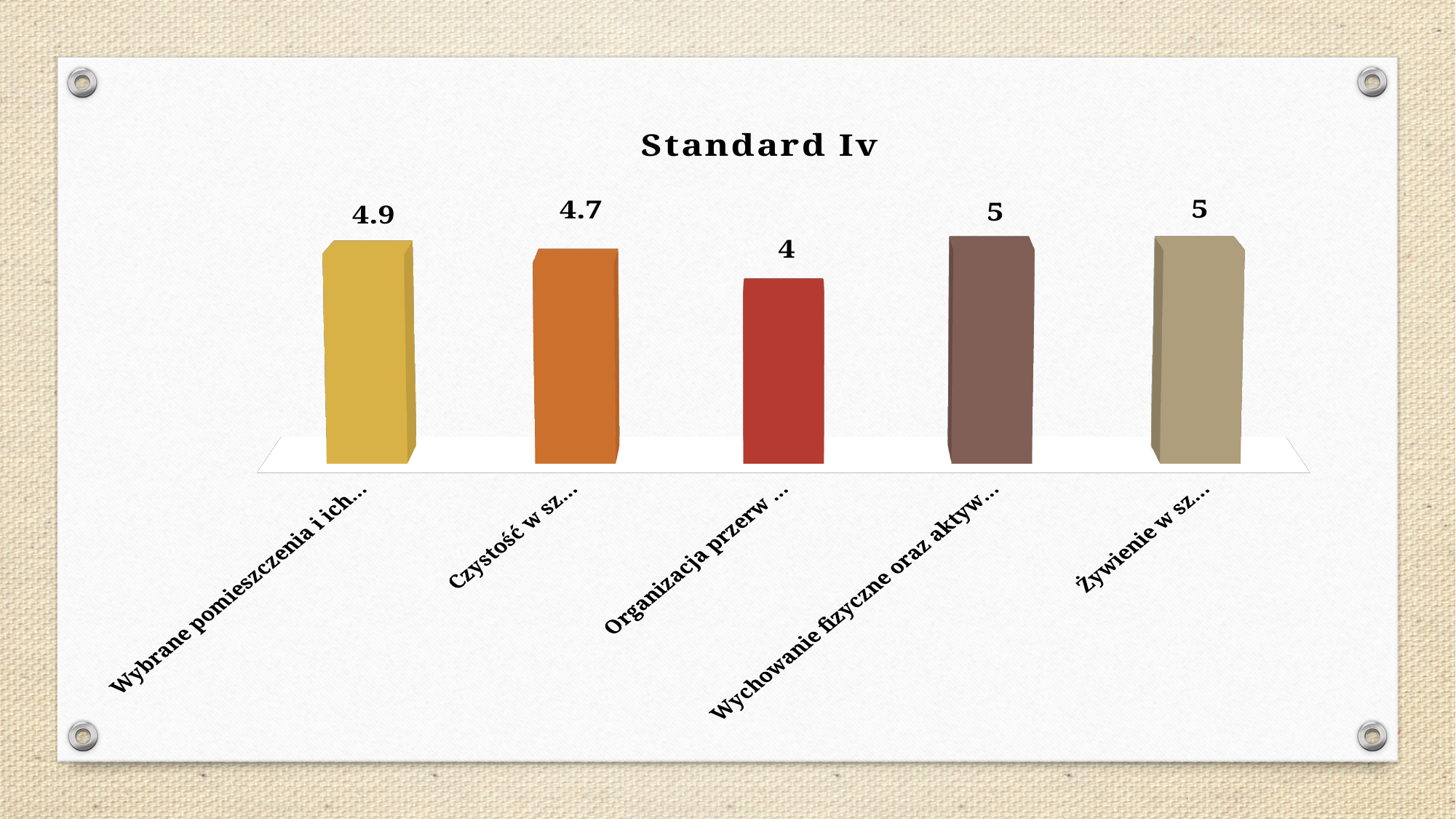
What is the value for the category beginning "Żywienie w sz"? 5 What is the title of the chart? Standard Iv Which category has the lowest value? Organizacja przerw ... What is the value for the category beginning "Wybrane pomieszczenia i ich"? 4.9 What type of chart is shown on the slide? bar chart What is the value for the category beginning "Czystość w sz"? 4.7 What is the difference between the values for "Wybrane pomieszczenia i ich..." and "Organizacja przerw ..."? 0.9 What is the value for the category beginning "Wychowanie fizyczne oraz aktyw"? 5 How many bars does the chart have? 5 What colour is the bar for "Organizacja przerw ..."? red Which is larger, the value for "Czystość w sz..." or the value for "Żywienie w sz..."? Żywienie w sz... What is the value for the category beginning "Organizacja przerw"? 4